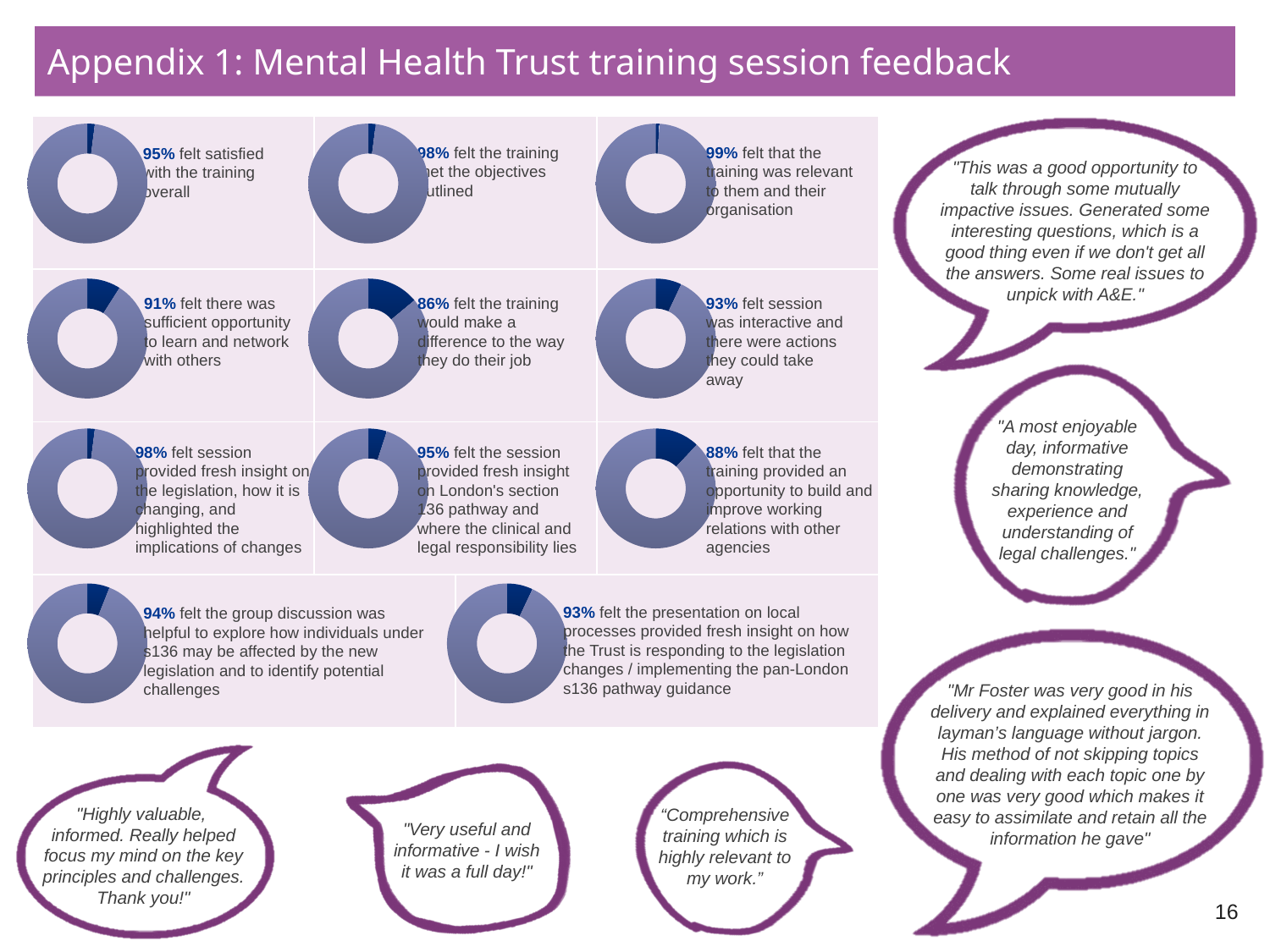
Across all the donut charts on the slide, which statement has the highest percentage? 99% felt that the training was relevant to them and their organisation What percentage felt the training would make a difference to the way they do their job, as shown by the middle donut chart in the second row? 86% In the donut chart for 'felt that the training provided an opportunity to build and improve working relations with other agencies', what share does the large light-coloured segment represent? 88% Across all the donut charts on the slide, which statement has the lowest percentage? 86% felt the training would make a difference to the way they do their job Which is larger: the percentage who felt there was sufficient opportunity to learn and network, or the percentage who felt the training would make a difference to their job? Sufficient opportunity to learn and network (91%) What percentage of attendees felt satisfied with the training overall, according to the top-left donut chart? 95% What is the difference in percentage points between the highest value (training was relevant) and the lowest value (would make a difference to their job)? 13 percentage points What type of chart is used to display the feedback percentages on the slide? Donut (pie) chart What is the title of the slide containing the feedback charts? Appendix 1: Mental Health Trust training session feedback How many donut charts are shown on the slide? 11 What percentage felt the presentation on local processes provided fresh insight, according to the donut chart in the bottom row, right? 93% According to the donut chart in the top row, middle column, what percentage felt the training met the objectives outlined? 98%